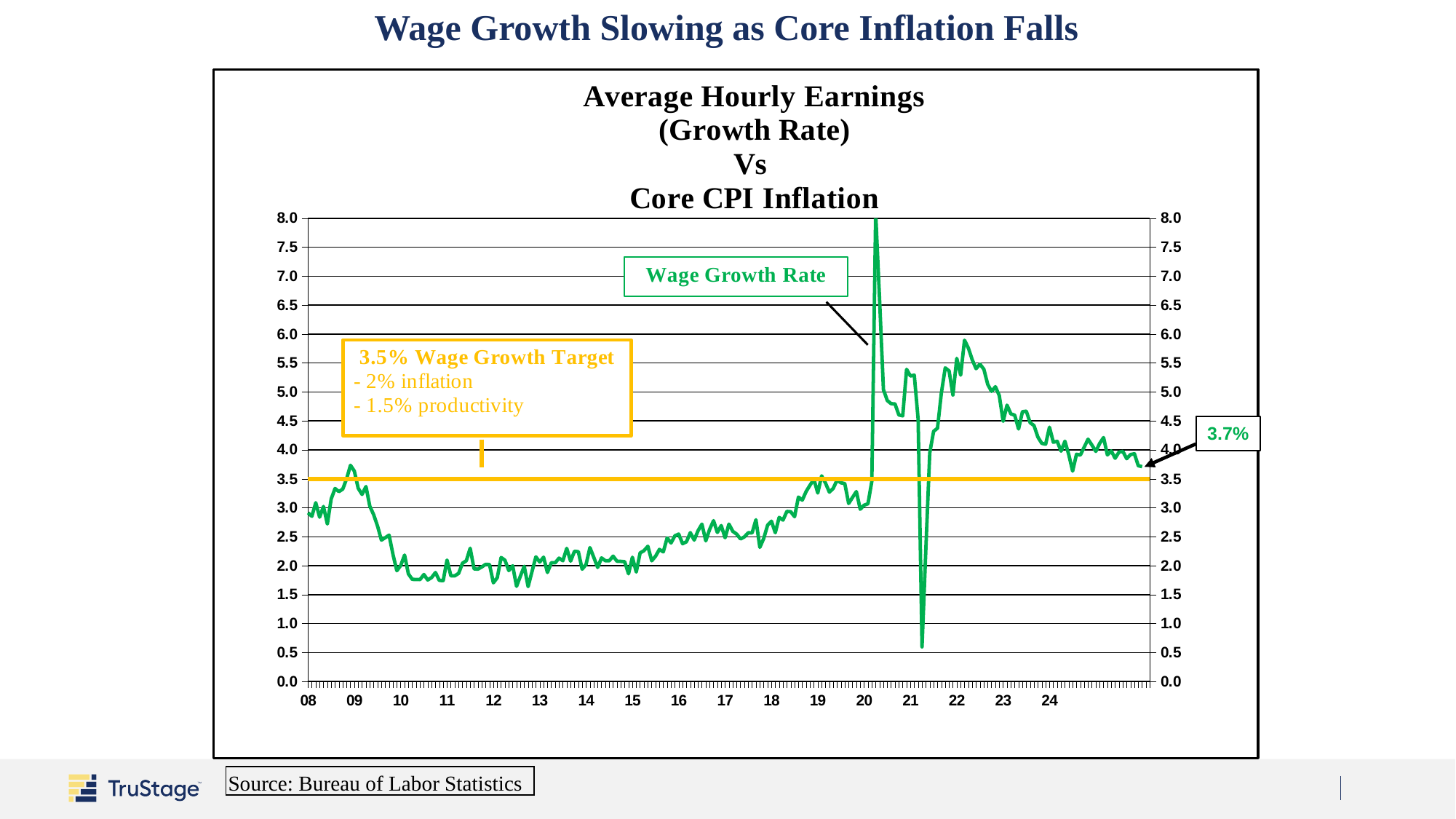
By how many percentage points does the latest Wage Growth Rate of 3.7% exceed the 3.5% target? 0.2 Is the Wage Growth Rate in 2022 greater or less than 4.5? greater Is the peak of the Wage Growth Rate in 2020 greater or less than 7.0? greater What kind of chart is shown on the slide? line chart Is the latest Wage Growth Rate of 3.7% above or below the 3.5% Wage Growth Target? above From 2022 to 2024, does the Wage Growth Rate rise or fall? fall What is the most recent value of the Wage Growth Rate labeled on the chart? 3.7% What value does the horizontal yellow Wage Growth Target line mark? 3.5% What two components make up the 3.5% Wage Growth Target according to the annotation? 2% inflation and 1.5% productivity Is the Wage Growth Rate in 2012 greater or less than 3.0? less What is the title of the chart? Average Hourly Earnings (Growth Rate) Vs Core CPI Inflation